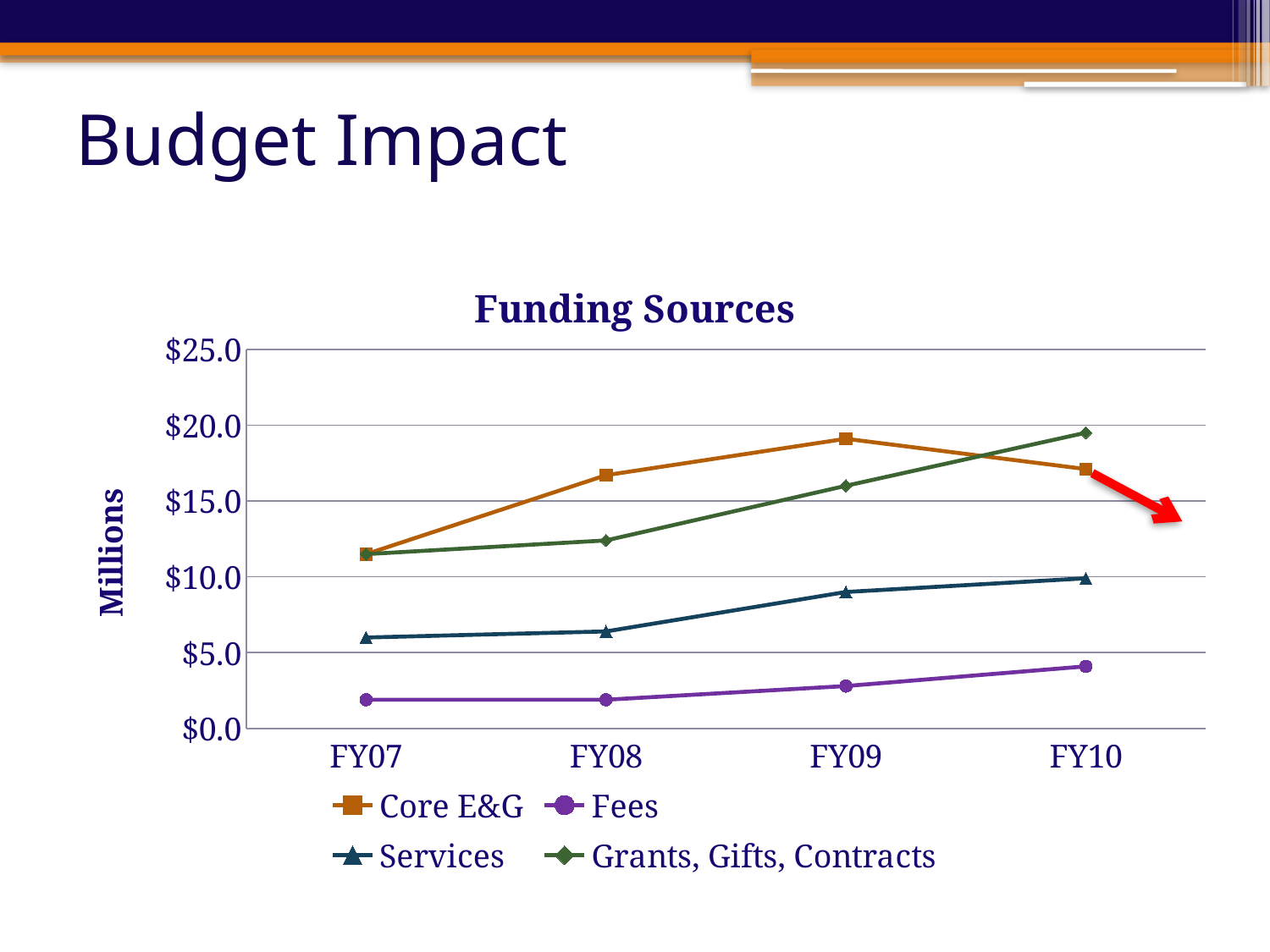
What is the label on the vertical axis of the chart? Millions Is the value for Fees in FY10 greater or less than $5.0? less Is the value for Grants, Gifts, Contracts in FY08 greater or less than $10.0? greater In FY10, which is larger: Core E&G or Grants, Gifts, Contracts? Grants, Gifts, Contracts Which series has the lowest values across all fiscal years? Fees Is the value for Core E&G in FY09 greater or less than $15.0? greater How many fiscal years are plotted along the x axis of the Funding Sources chart? 4 What kind of chart is shown on the slide? line chart In FY08, which is larger: Core E&G or Grants, Gifts, Contracts? Core E&G How many series does the legend of the Funding Sources chart list? 4 Does the Grants, Gifts, Contracts line rise or fall from FY07 to FY10? rise